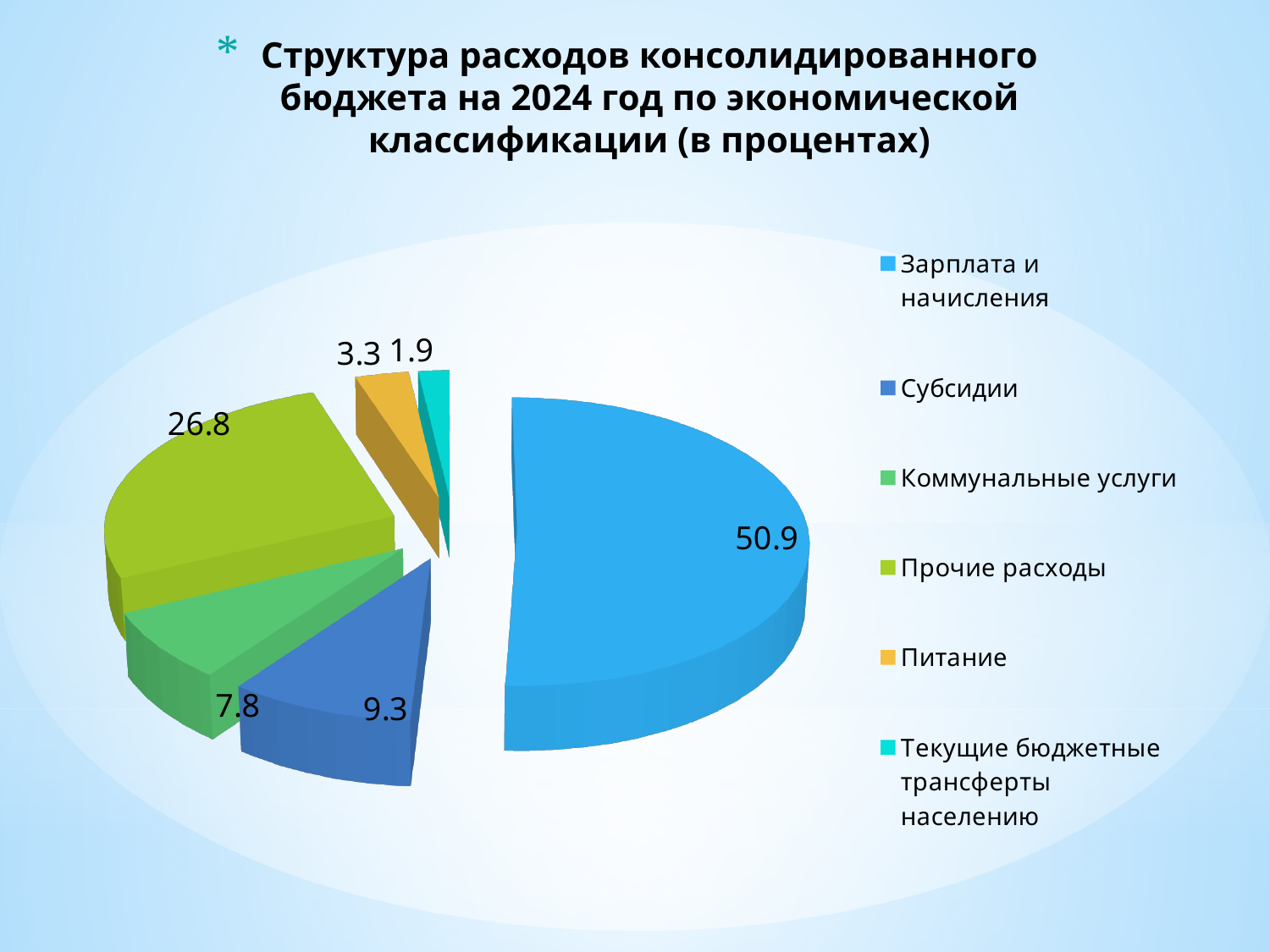
What is the value for Зарплата и начисления? 50.9 How many categories does the legend list? 6 What is the value for Текущие бюджетные трансферты населению? 1.9 What is the value for Коммунальные услуги? 7.8 Which is larger, the value for Субсидии or the value for Коммунальные услуги? Субсидии What is the value for Питание? 3.3 What kind of chart is shown on the slide? Pie chart What is the value for Субсидии? 9.3 Which category has the smallest share of the pie? Текущие бюджетные трансферты населению What is the difference between the values for Зарплата и начисления and Прочие расходы? 24.1 What is the value for Прочие расходы? 26.8 Which category has the largest share of the pie? Зарплата и начисления